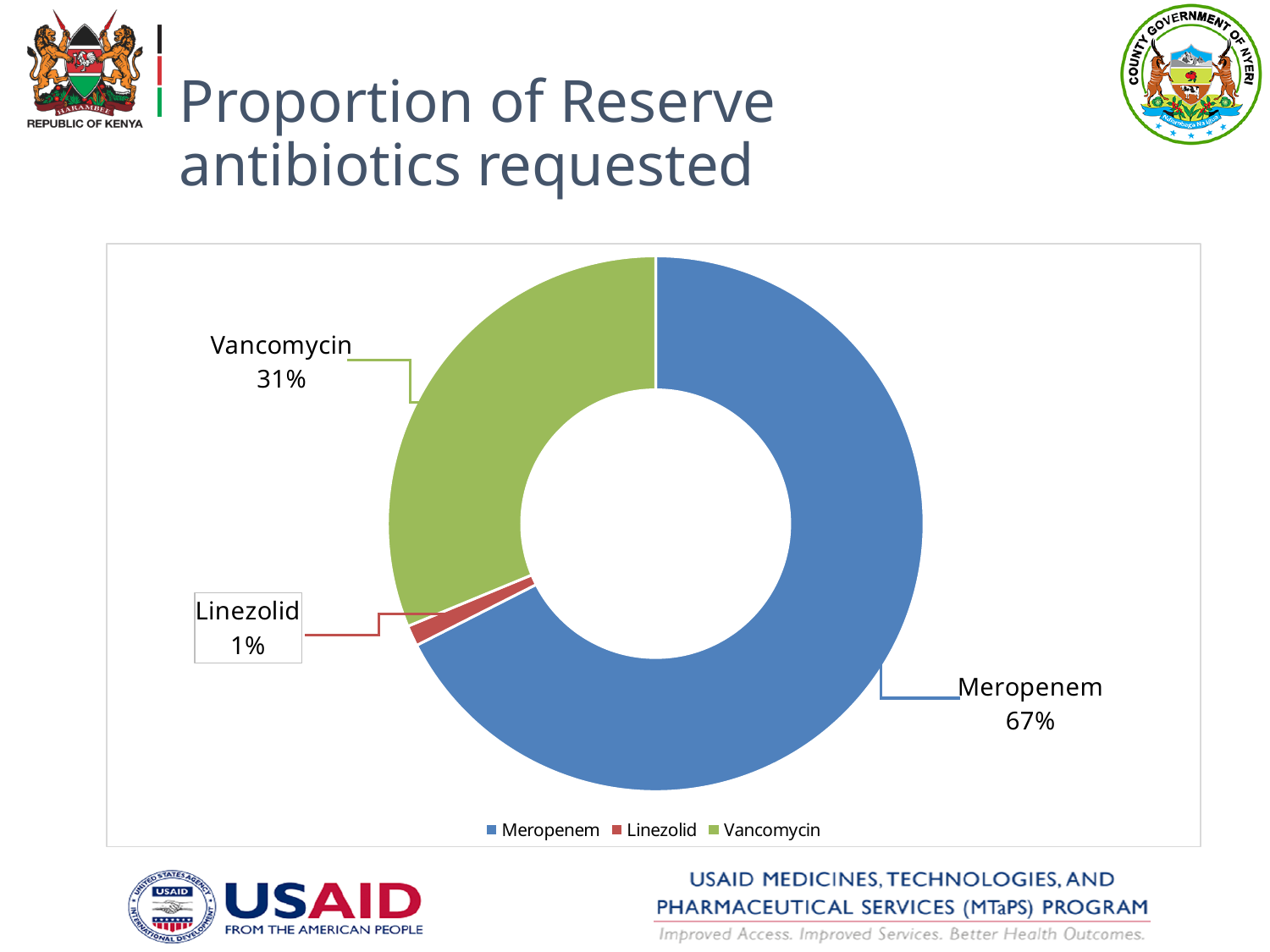
How many antibiotics are shown in the chart? 3 Which antibiotic has the smallest share of the chart? Linezolid What share of reserve antibiotics requested is Linezolid? 1% What colour represents Vancomycin in the chart? Green Which has a larger share, Vancomycin or Linezolid? Vancomycin What share of reserve antibiotics requested is Vancomycin? 31% What kind of chart is shown on the slide? Pie chart (doughnut) What is the difference in percentage points between the Vancomycin and Linezolid shares? 30 What is the title of the slide? Proportion of Reserve antibiotics requested What is the difference in percentage points between the Meropenem and Vancomycin shares? 36 What share of reserve antibiotics requested is Meropenem? 67% Which antibiotic has the largest share of the chart? Meropenem